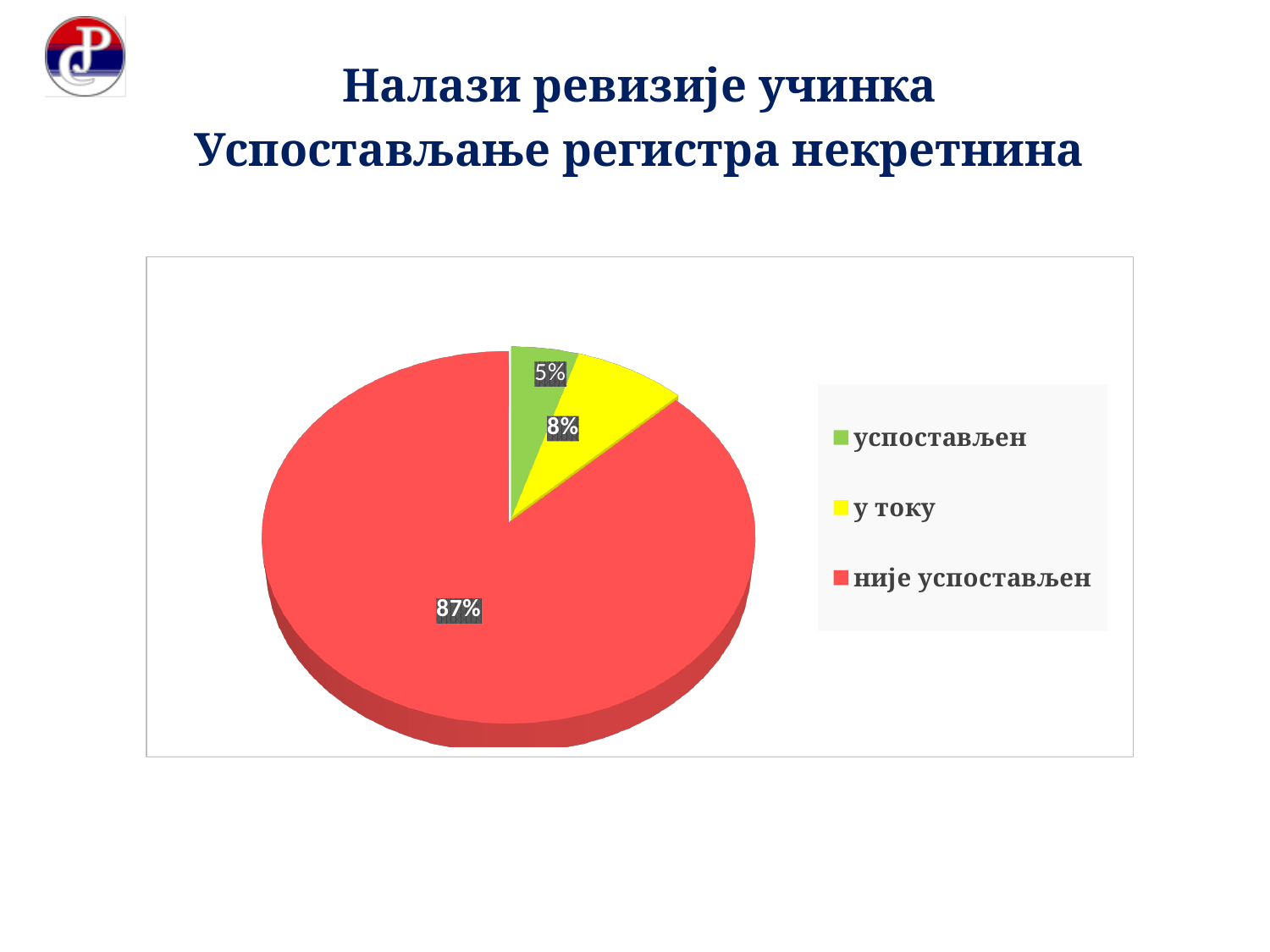
What colour is the 'у току' slice? yellow What is the difference in percentage points between the 'у току' slice and the 'успостављен' slice? 3 Which is larger, the 'у току' slice or the 'успостављен' slice? у току What colour is the 'није успостављен' slice? red What is the difference in percentage points between the 'није успостављен' slice and the 'у току' slice? 79 How many slices does the pie chart have? 3 Which category has the smallest slice of the pie? успостављен What share of the pie does the 'успостављен' slice represent? 5% What kind of chart is shown on the slide? pie chart Which category has the largest slice of the pie? није успостављен What share of the pie does the 'у току' slice represent? 8% What share of the pie does the 'није успостављен' slice represent? 87%